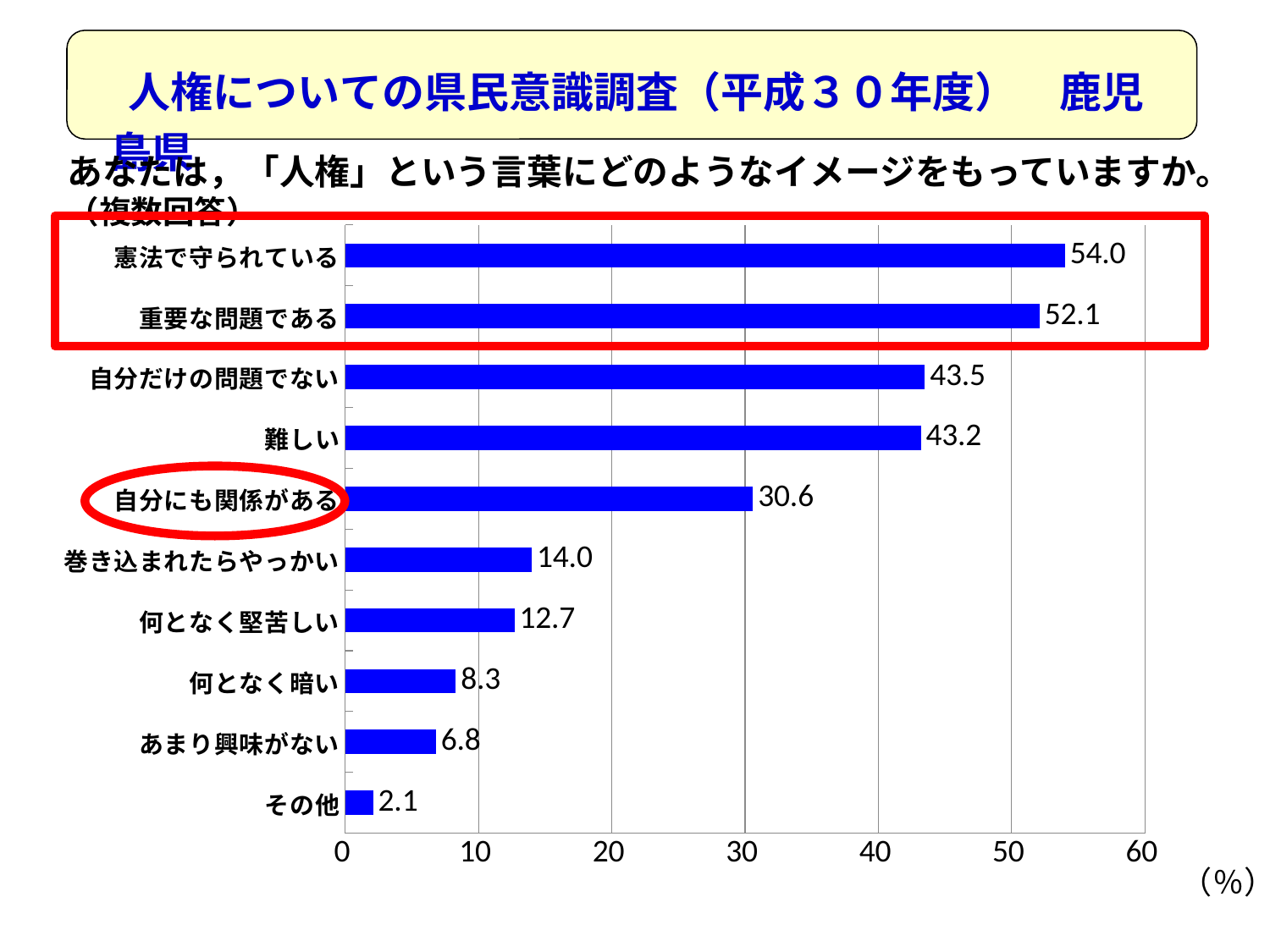
Is the value for 自分だけの問題でない greater or less than 40? greater What is the value for あまり興味がない? 6.8 What is the value for 自分にも関係がある? 30.6 What is the difference between the values for 巻き込まれたらやっかい and 何となく堅苦しい? 1.3 What is the value for 憲法で守られている? 54.0 What is the difference between the values for 憲法で守られている and 重要な問題である? 1.9 Which is larger, the value for 難しい or the value for 自分にも関係がある? 難しい What unit is shown for the values on the chart's axis? % What kind of chart is shown on the slide? bar chart Which category has the lowest value? その他 How many categories are shown in the chart? 10 Which category has the highest value? 憲法で守られている